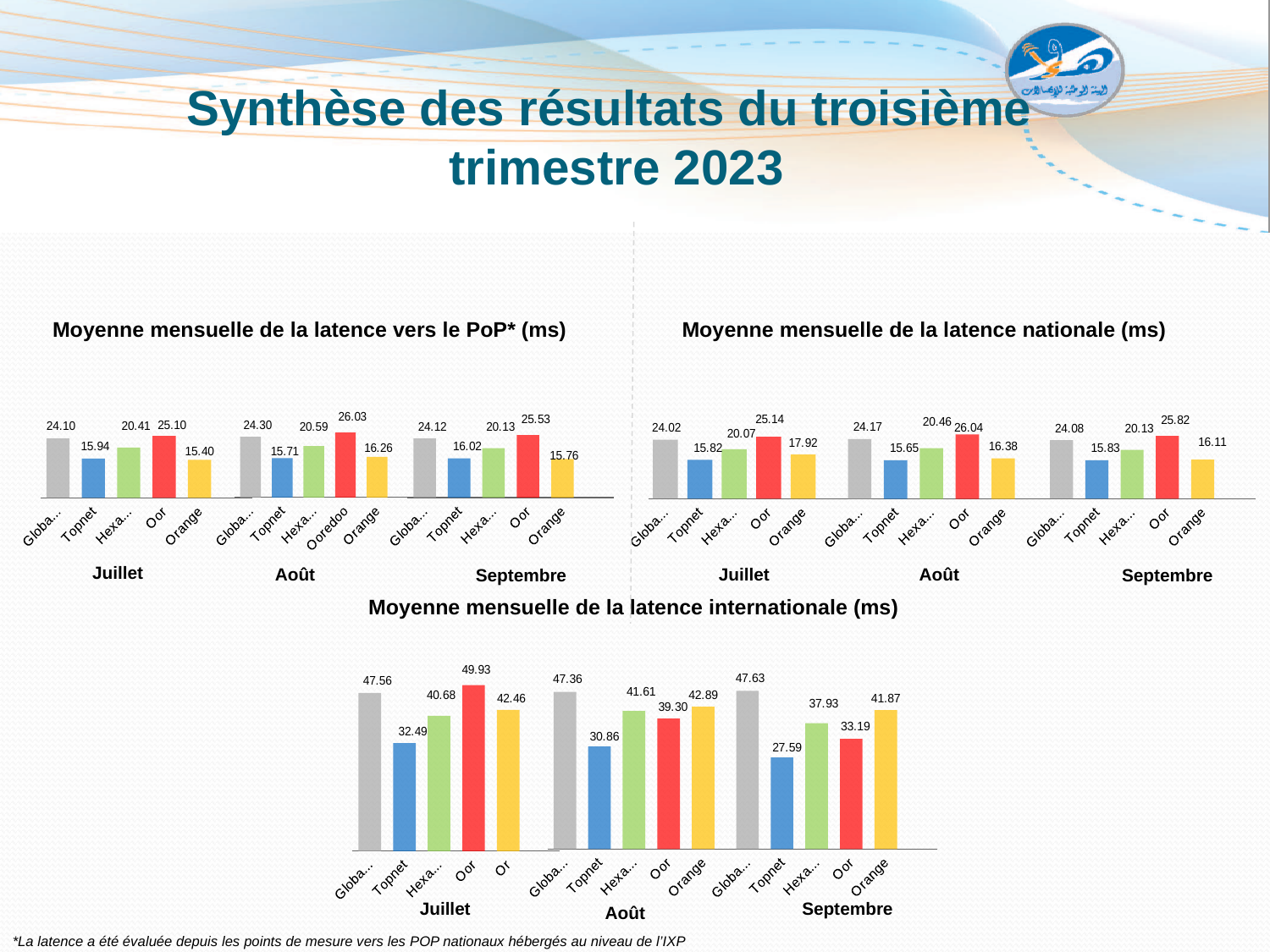
How many months are shown in the chart 'Moyenne mensuelle de la latence internationale (ms)'? 3 In the chart 'Moyenne mensuelle de la latence nationale (ms)', what is the value for Orange in Juillet? 17.92 In the chart 'Moyenne mensuelle de la latence internationale (ms)', what is the difference between the Orange value in Août and the Orange value in Juillet? 0.43 In the chart 'Moyenne mensuelle de la latence vers le PoP* (ms)', what is the value for Ooredoo in Août? 26.03 In the chart 'Moyenne mensuelle de la latence internationale (ms)', what is the value for Orange in Août? 42.89 In the chart 'Moyenne mensuelle de la latence internationale (ms)', which month has the lowest value for Topnet? Septembre In the chart 'Moyenne mensuelle de la latence nationale (ms)', what is the value for Topnet in Août? 15.65 In the chart 'Moyenne mensuelle de la latence nationale (ms)', which is larger: the Orange value in Juillet or the Orange value in Septembre? Orange in Juillet In the chart 'Moyenne mensuelle de la latence internationale (ms)', what is the value for Topnet in Septembre? 27.59 In the chart 'Moyenne mensuelle de la latence vers le PoP* (ms)', what is the value for Topnet in Juillet? 15.94 In the chart 'Moyenne mensuelle de la latence vers le PoP* (ms)', what is the value for Orange in Septembre? 15.76 What kind of chart is 'Moyenne mensuelle de la latence nationale (ms)'? Bar chart